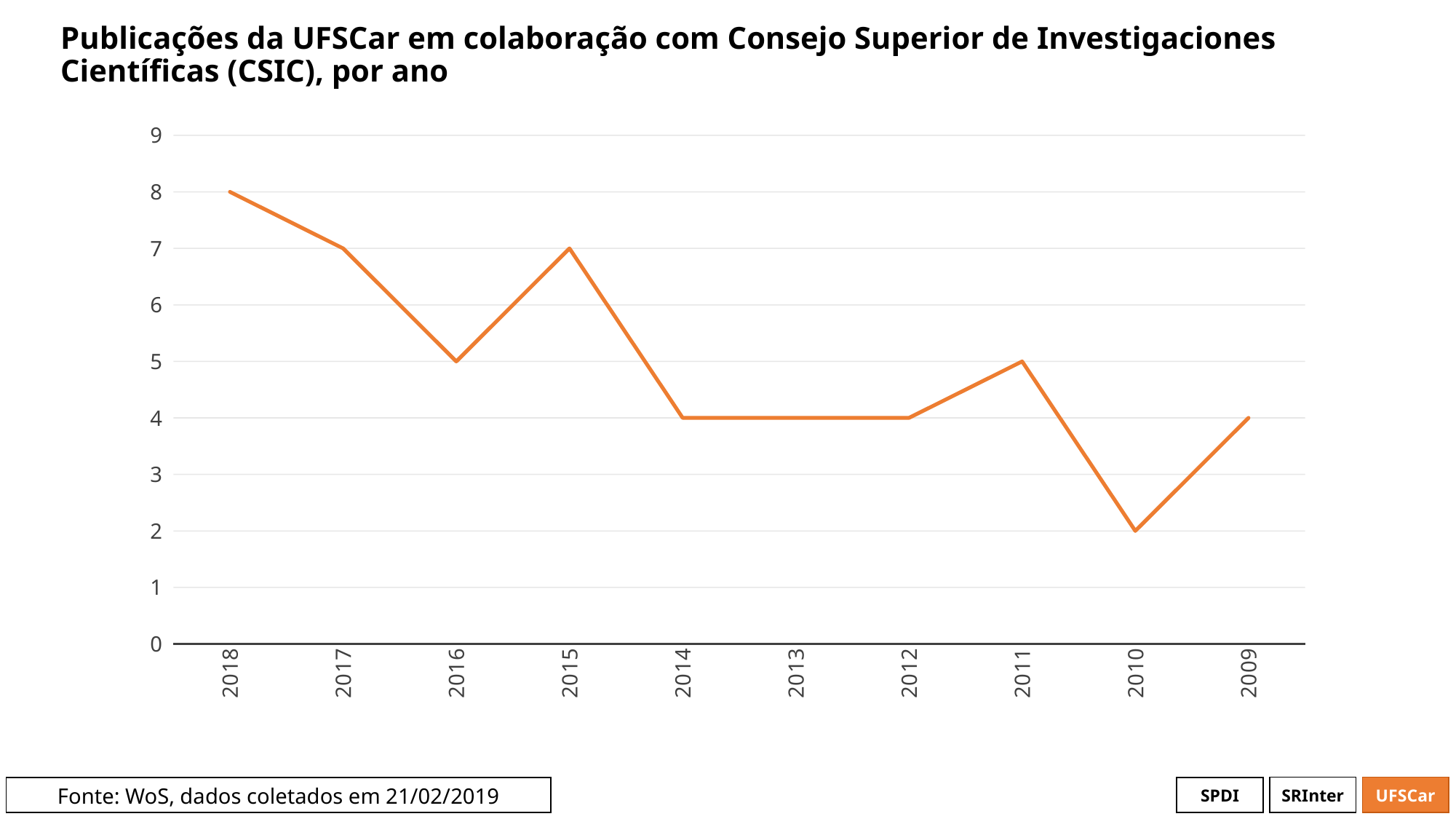
Which year has the lowest value? 2010 What is the source cited at the bottom of the slide? WoS, dados coletados em 21/02/2019 What is the value for 2011? 5 What type of chart is shown on the slide? line chart Which year has the highest value? 2018 What is the value for 2015? 7 What is the value for 2018? 8 What is the value for 2010? 2 What is the difference between the values for 2018 and 2010? 6 Which is larger, the value for 2016 or the value for 2015? 2015 How many years are plotted on the x axis? 10 Moving from 2018 to 2016 along the x axis, do the values rise or fall? fall